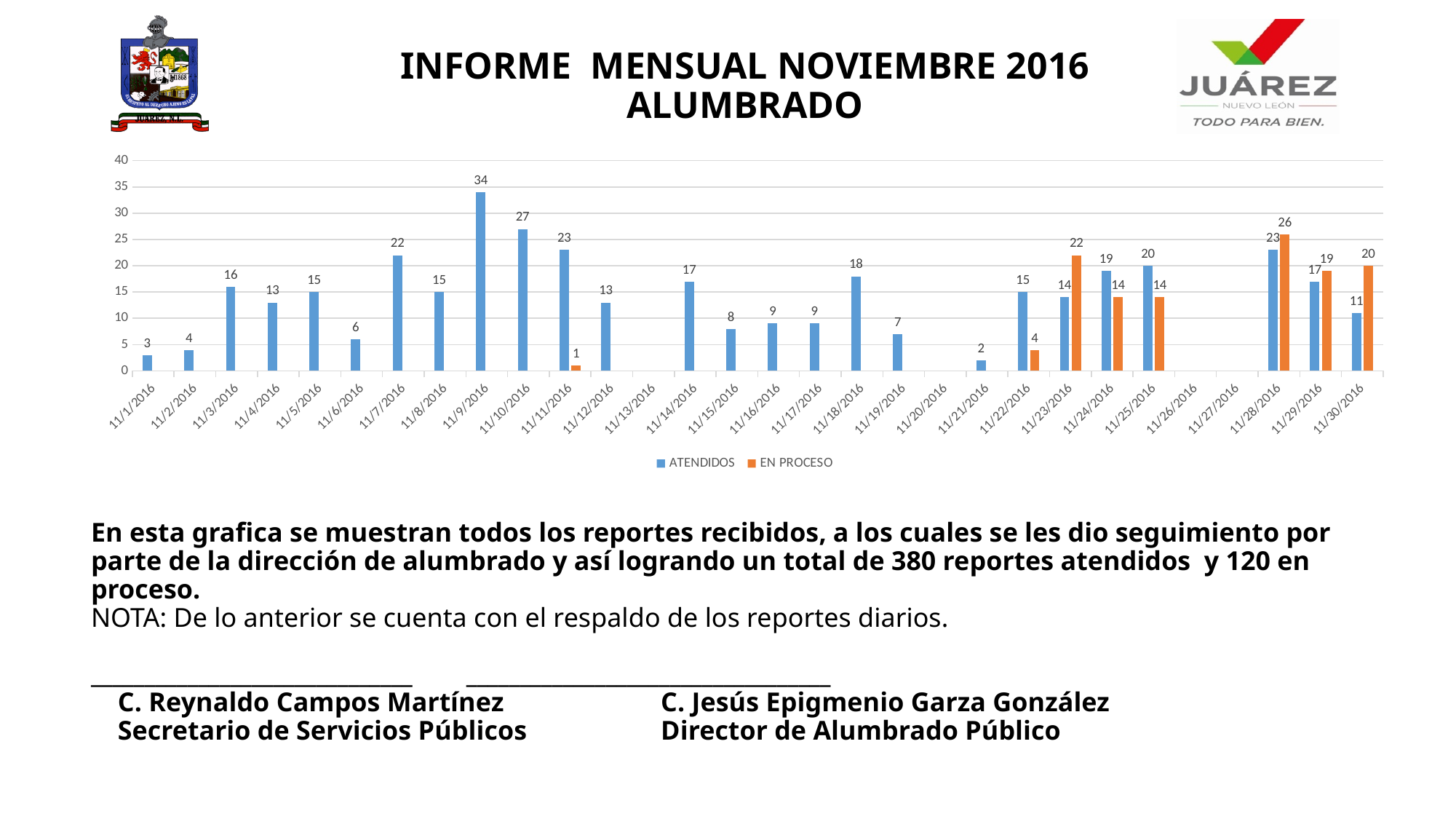
What is the EN PROCESO value for 11/28/2016? 26 Which date has the highest ATENDIDOS value? 11/9/2016 What are the two legend entries of the chart? ATENDIDOS and EN PROCESO What is the difference between the ATENDIDOS values for 11/9/2016 and 11/10/2016? 7 On 11/23/2016, which is larger: ATENDIDOS or EN PROCESO? EN PROCESO What kind of chart is shown on the slide? Bar chart Which date has the highest EN PROCESO value? 11/28/2016 Which is larger: the ATENDIDOS value for 11/7/2016 or for 11/18/2016? 11/7/2016 What is the ATENDIDOS value for 11/9/2016? 34 How many series does the legend list? 2 How many dates are shown on the x axis? 30 What is the ATENDIDOS value for 11/21/2016? 2